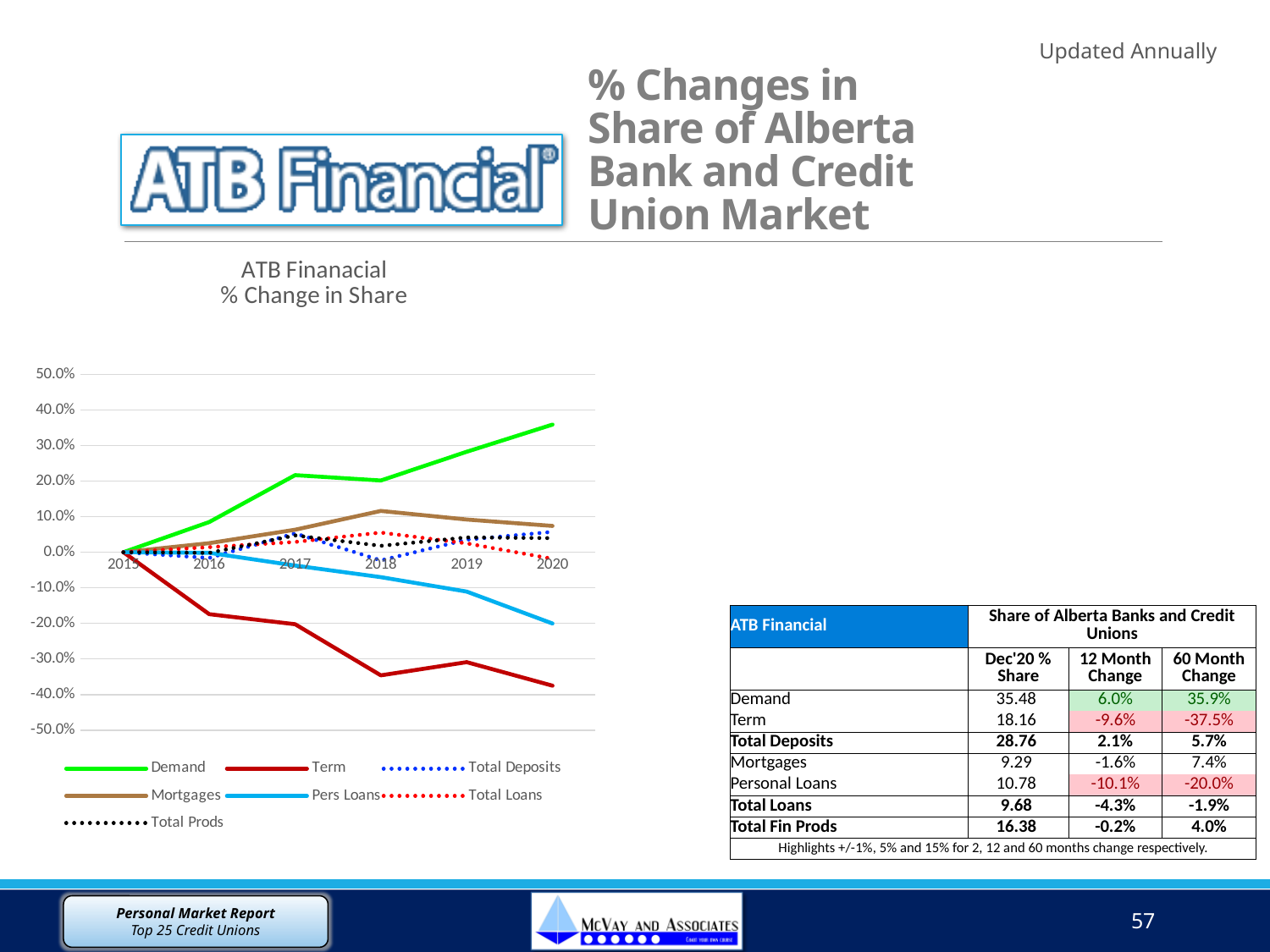
Is the value for Mortgages in 2020 greater or less than 0.0%? greater Is the value for Pers Loans in 2019 greater or less than 0.0%? less How many years are shown along the x axis of the chart? 6 How many series does the chart legend list? 7 What kind of chart is shown on the slide? line chart Does the Pers Loans series rise or fall from 2017 to 2020? fall Which series has the lowest value in 2020? Term Which is larger in 2020, the value for Demand or the value for Mortgages? Demand Does the Demand series generally rise or fall from 2015 to 2020? rise Is the value for Term in 2020 greater or less than -30.0%? less Which series has the highest value in 2020? Demand